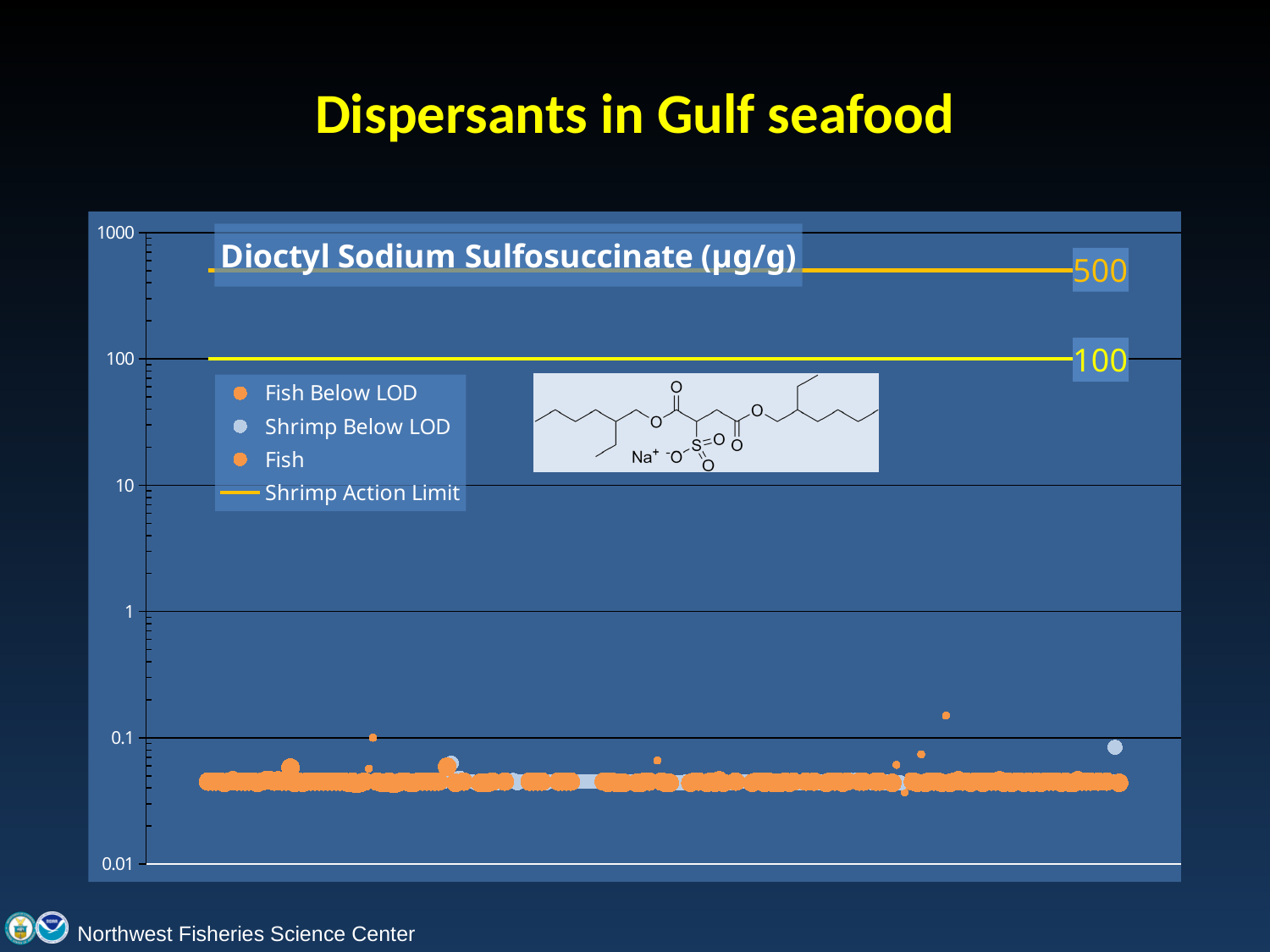
What is the label on the upper horizontal line in the chart? 500 Which is larger, the value of the upper horizontal line or the lower horizontal line? the upper horizontal line (500) Is the upper horizontal line greater or less than 100 on the y axis? greater Which legend entry is drawn as a line rather than a marker? Shrimp Action Limit What is the label on the lower horizontal line in the chart? 100 What is the lowest value shown on the y axis? 0.01 Are the Fish data points greater or less than 1 on the y axis? less What is the difference between the two labelled horizontal line values? 400 What is the title of the chart? Dioctyl Sodium Sulfosuccinate (µg/g) How many entries does the chart legend list? 4 What kind of chart is shown on the slide? scatter chart What is the highest value shown on the y axis? 1000